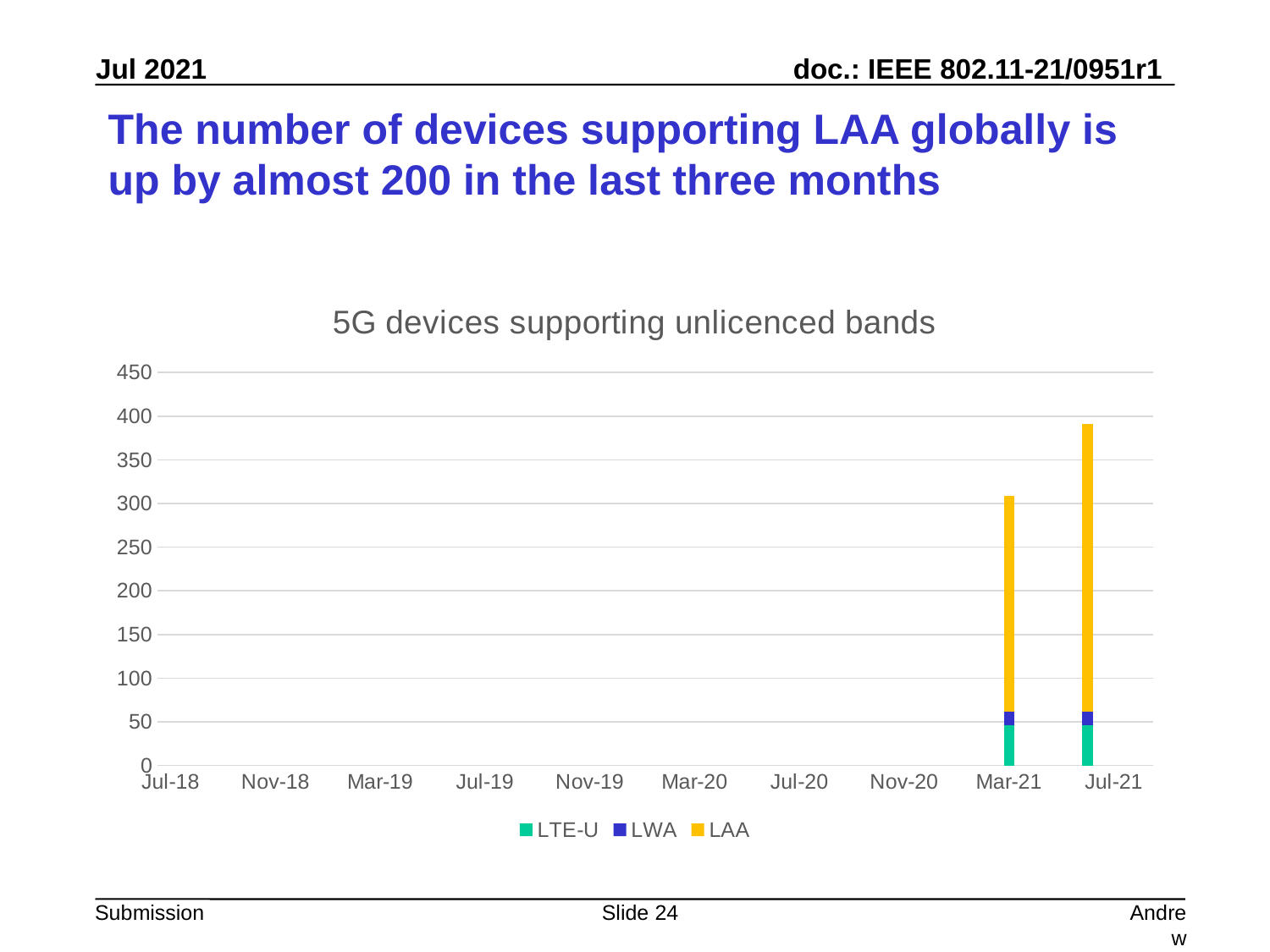
Which bar is taller in total, Mar-21 or Jul-21? Jul-21 Is the total height of the Mar-21 bar greater or less than 250? greater What is the title of the chart? 5G devices supporting unlicenced bands What kind of chart is shown on the slide? stacked bar chart Which series are listed in the chart's legend? LTE-U, LWA, LAA Which series makes up the largest part of the Jul-21 bar? LAA Does the total number of devices rise or fall from Mar-21 to Jul-21? rise How many series does the chart's legend list? 3 Which series makes up the smallest part of the Mar-21 bar? LWA Is the total height of the Jul-21 bar greater or less than 350? greater Is the total height of the Mar-21 bar greater or less than 350? less How many date labels are shown along the x axis? 10